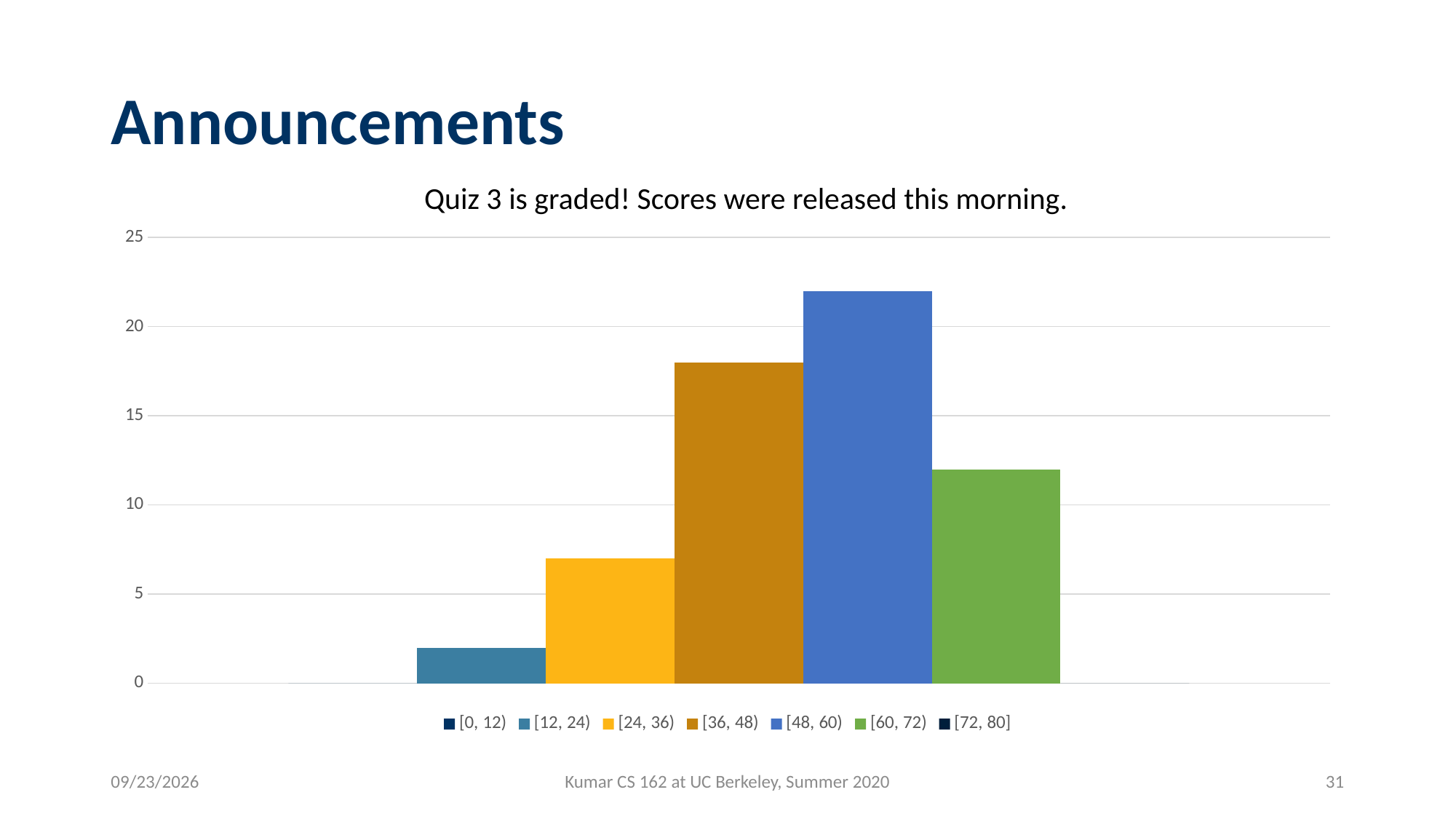
What is the title of the chart? Quiz 3 is graded! Scores were released this morning. Which is larger, the bar for [36, 48) or the bar for [60, 72)? [36, 48) Which score range has the tallest bar? [48, 60) How many bars are visible in the chart? 5 How many series does the legend list? 7 Which of the visible bars is the shortest? [12, 24) Is the value for [36, 48) greater or less than 15? greater Is the value for [60, 72) greater or less than 10? greater Is the value for [48, 60) greater or less than 20? greater What kind of chart is shown on the slide? bar chart Which is larger, the bar for [24, 36) or the bar for [60, 72)? [60, 72)